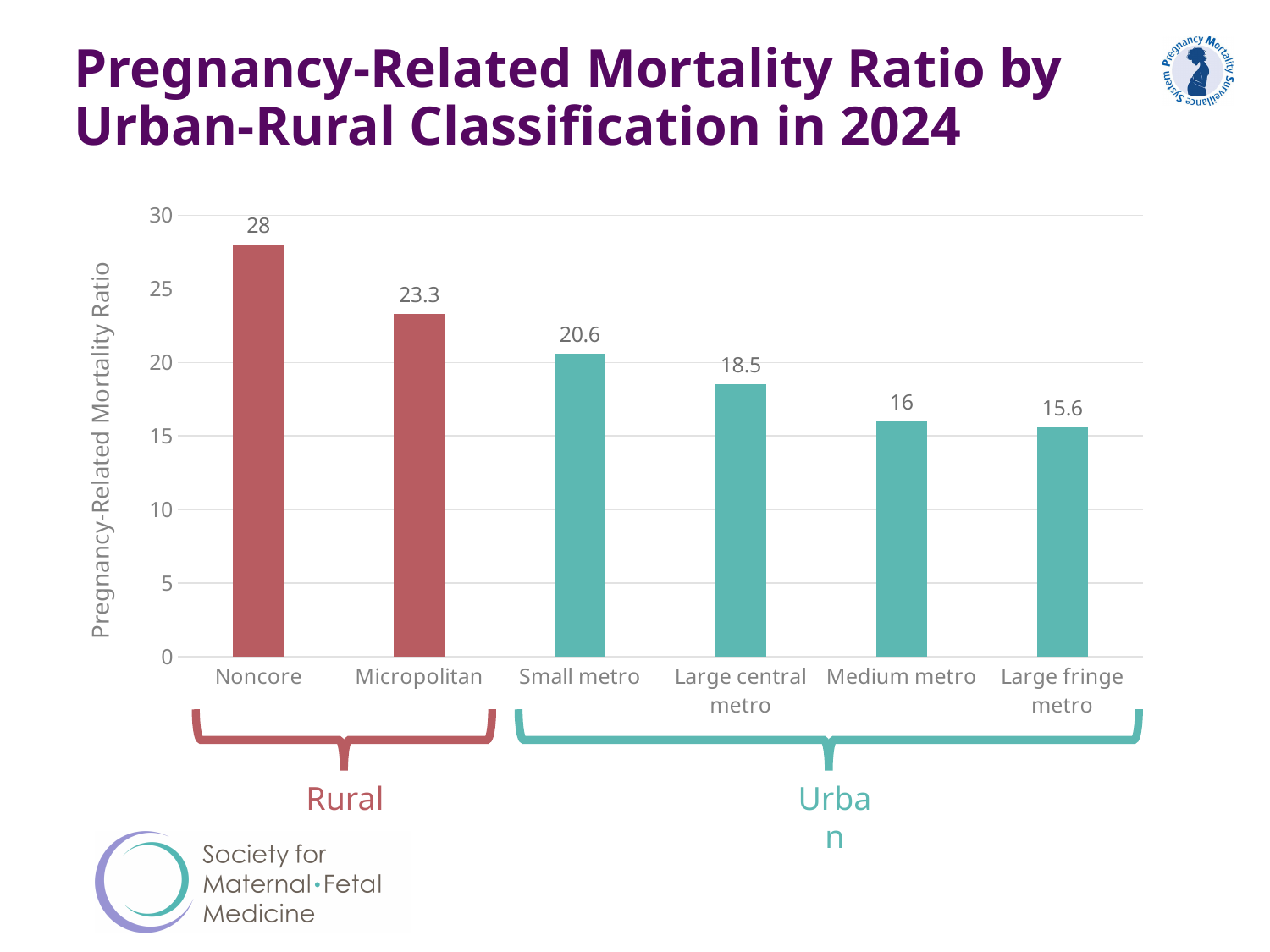
What kind of chart is shown on the slide? Bar chart How many urban-rural categories are shown on the chart? 6 Which category has the highest pregnancy-related mortality ratio? Noncore Which categories are grouped under the Rural bracket? Noncore and Micropolitan What is the difference between the mortality ratio for Small metro and for Medium metro? 4.6 What is the pregnancy-related mortality ratio for Large fringe metro? 15.6 What is the pregnancy-related mortality ratio for Noncore? 28 Which has a higher pregnancy-related mortality ratio, Micropolitan or Small metro? Micropolitan Is the value for Medium metro greater or less than 20? less What is the pregnancy-related mortality ratio for Large central metro? 18.5 What is the difference between the mortality ratio for Noncore and for Micropolitan? 4.7 Which category has the lowest pregnancy-related mortality ratio? Large fringe metro